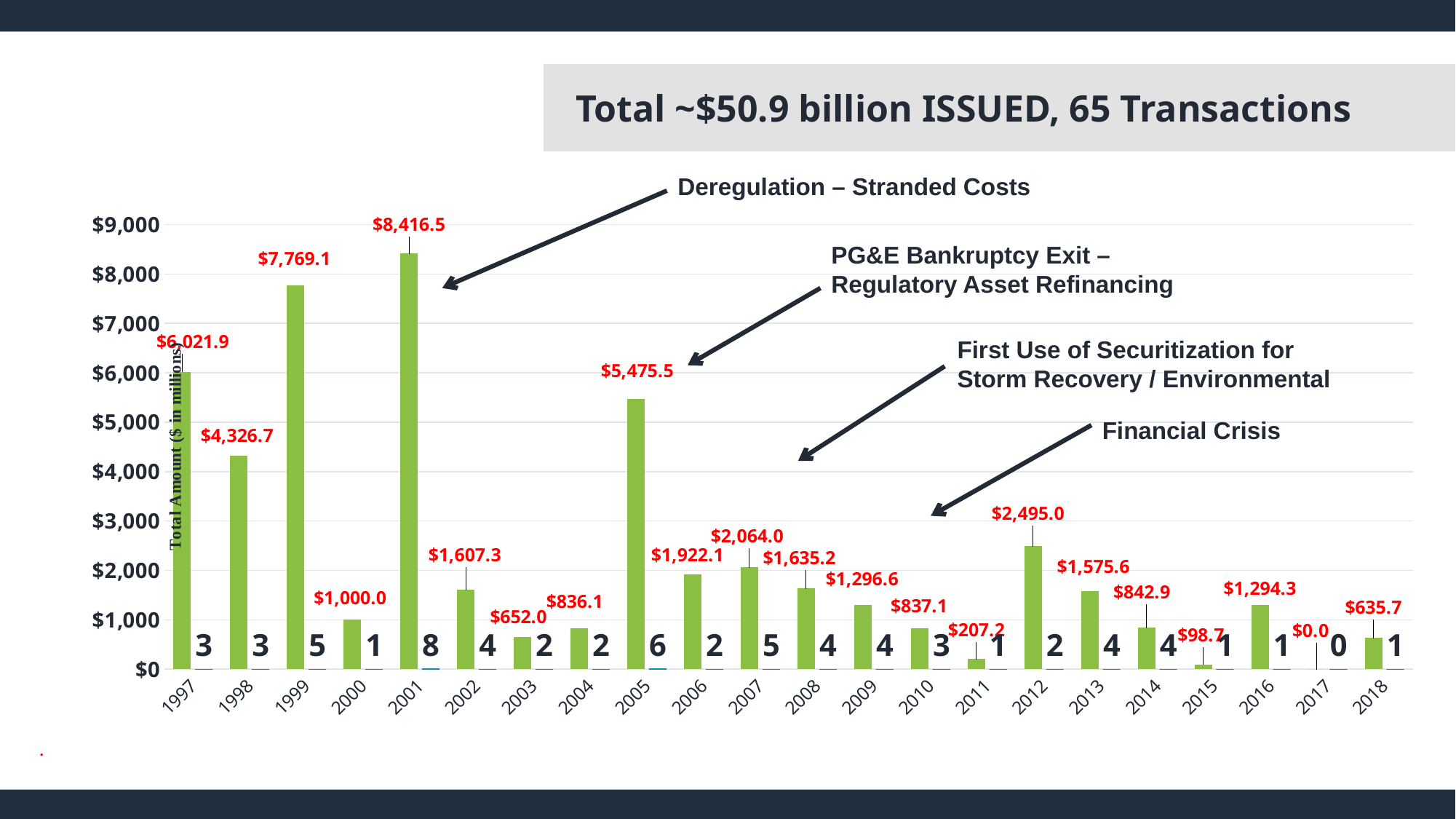
What kind of chart is this? bar chart What is the value for 2001? $8,416.5 What is the difference between the values for 2001 and 1999? $647.4 Which year has the highest value? 2001 What is the value for 2005? $5,475.5 Which year has the lowest value? 2017 How many years are shown on the x axis? 22 What is the title shown above the chart? Total ~$50.9 billion ISSUED, 65 Transactions What is the difference between the values for 2012 and 2013? $919.4 What is the value for 2012? $2,495.0 Which is larger, the value for 1997 or the value for 1998? 1997 Is the value for 2007 greater or less than $2,000? greater